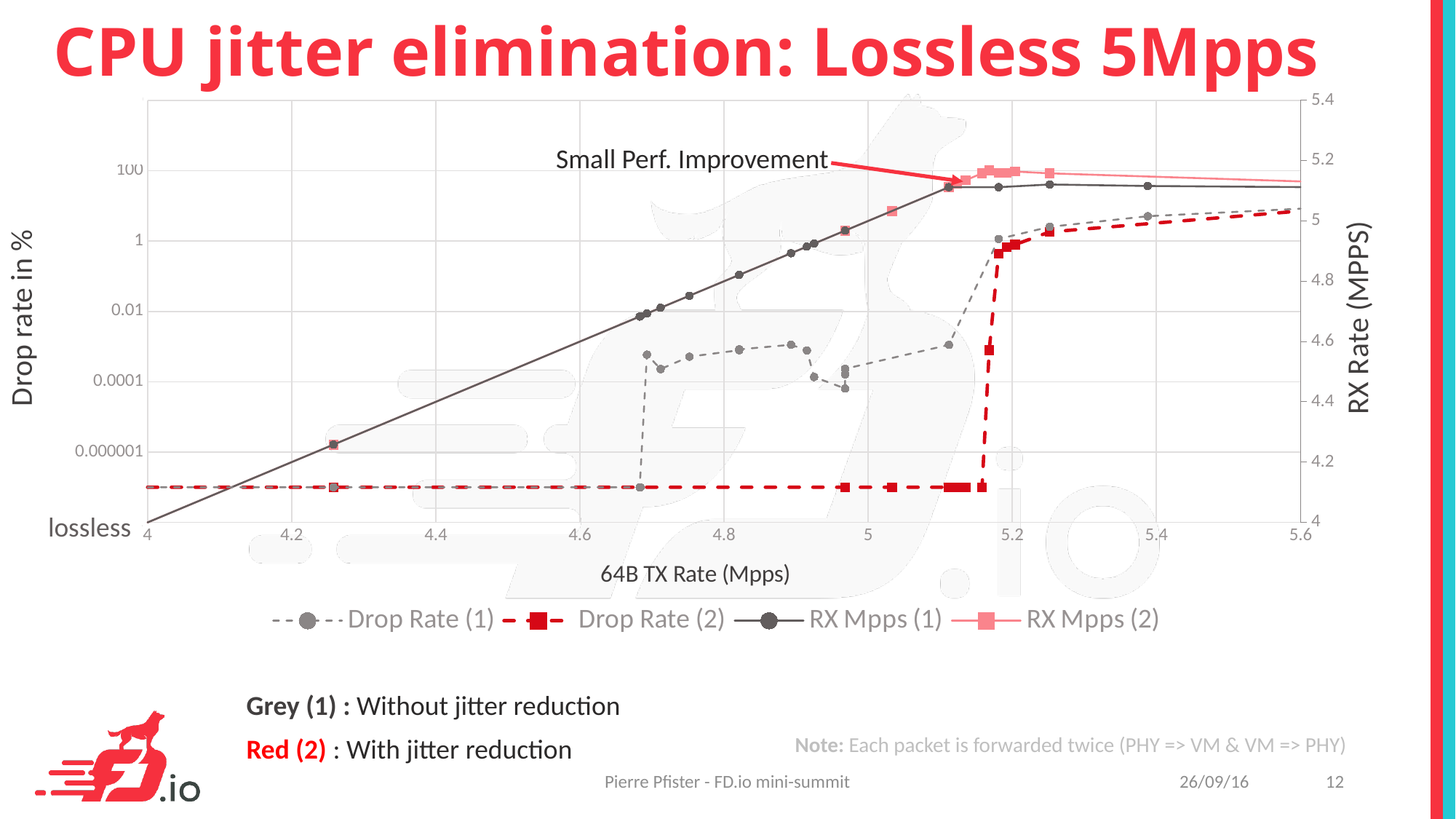
Does the RX Mpps (1) series rise or fall as the TX rate increases from 4 to 5.2 Mpps? rise Is the Drop Rate (2) value at a TX rate of 5.6 Mpps greater or less than 1%? greater Is the Drop Rate (1) value at a TX rate of 4.8 Mpps greater or less than 0.01%? less How many series does the chart legend list? 4 Is the RX Mpps (2) value at a TX rate of 5.6 Mpps greater or less than 5? greater At a TX rate of 5.0 Mpps, which series has the higher drop rate, Drop Rate (1) or Drop Rate (2)? Drop Rate (1) What kind of chart is shown on the slide? line chart What is the title of the x axis of the chart? 64B TX Rate (Mpps) What text does the red arrow annotation on the chart point with? Small Perf. Improvement Does the Drop Rate (2) series rise or fall overall as the TX rate increases from 5.0 to 5.6 Mpps? rise